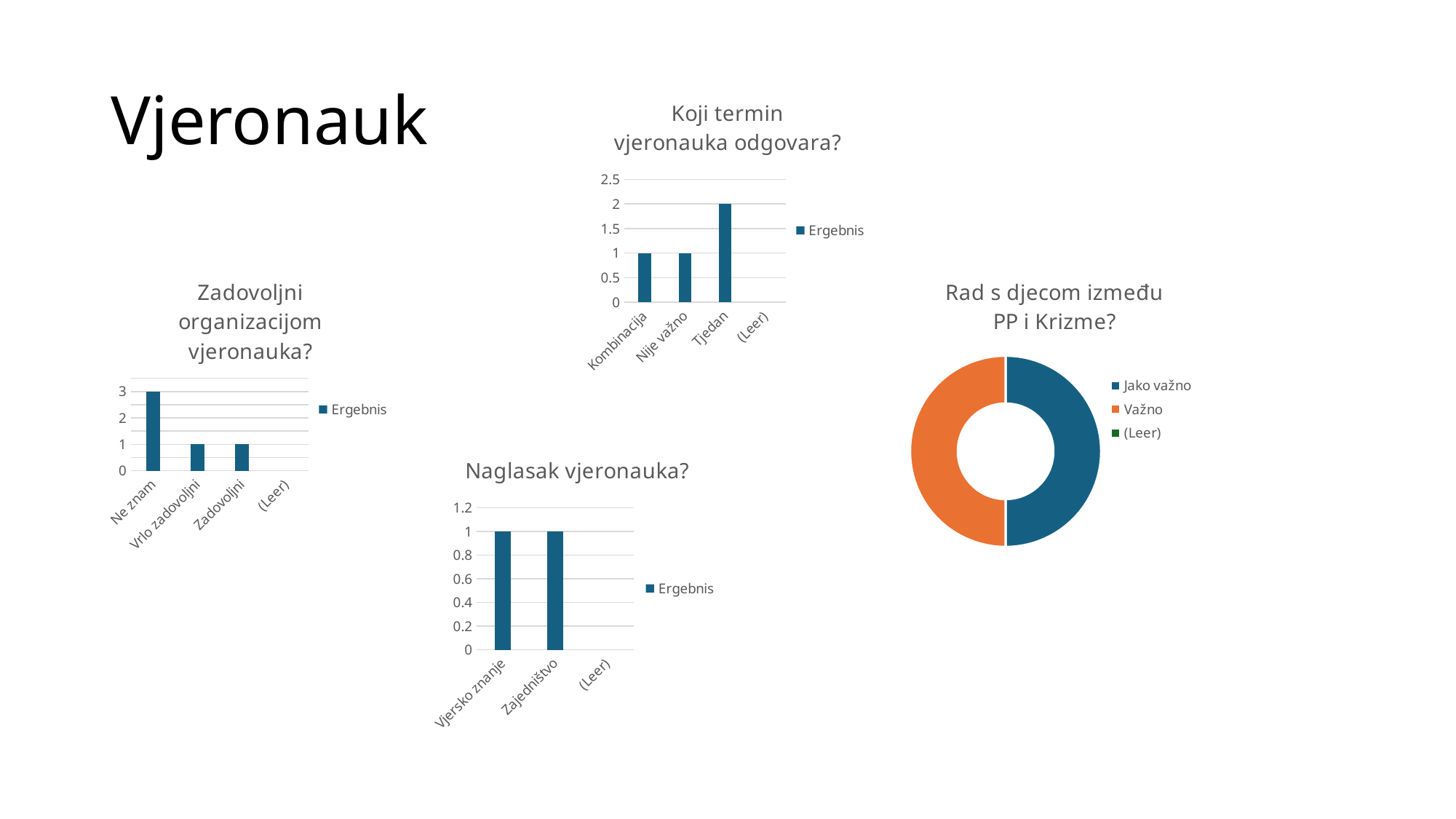
How many entries does the legend of the chart titled "Rad s djecom između PP i Krizme?" list? 3 In the chart titled "Koji termin vjeronauka odgovara?", how many categories are shown on the x axis? 4 What kind of chart is the one titled "Rad s djecom između PP i Krizme?"? Doughnut chart In the chart titled "Naglasak vjeronauka?", what is the value for "Zajedništvo"? 1 What kind of chart is the one titled "Naglasak vjeronauka?"? Bar chart In the chart titled "Zadovoljni organizacijom vjeronauka?", what is the value for "Ne znam"? 3 In the chart titled "Koji termin vjeronauka odgovara?", which is larger, the value for "Tjedan" or the value for "Kombinacija"? Tjedan In the chart titled "Koji termin vjeronauka odgovara?", which category has the highest value? Tjedan In the chart titled "Koji termin vjeronauka odgovara?", what is the value for "Tjedan"? 2 In the chart titled "Zadovoljni organizacijom vjeronauka?", which category has the highest value? Ne znam In the chart titled "Zadovoljni organizacijom vjeronauka?", what is the difference between the values for "Ne znam" and "Zadovoljni"? 2 In the chart titled "Naglasak vjeronauka?", what is the value for "Vjersko znanje"? 1